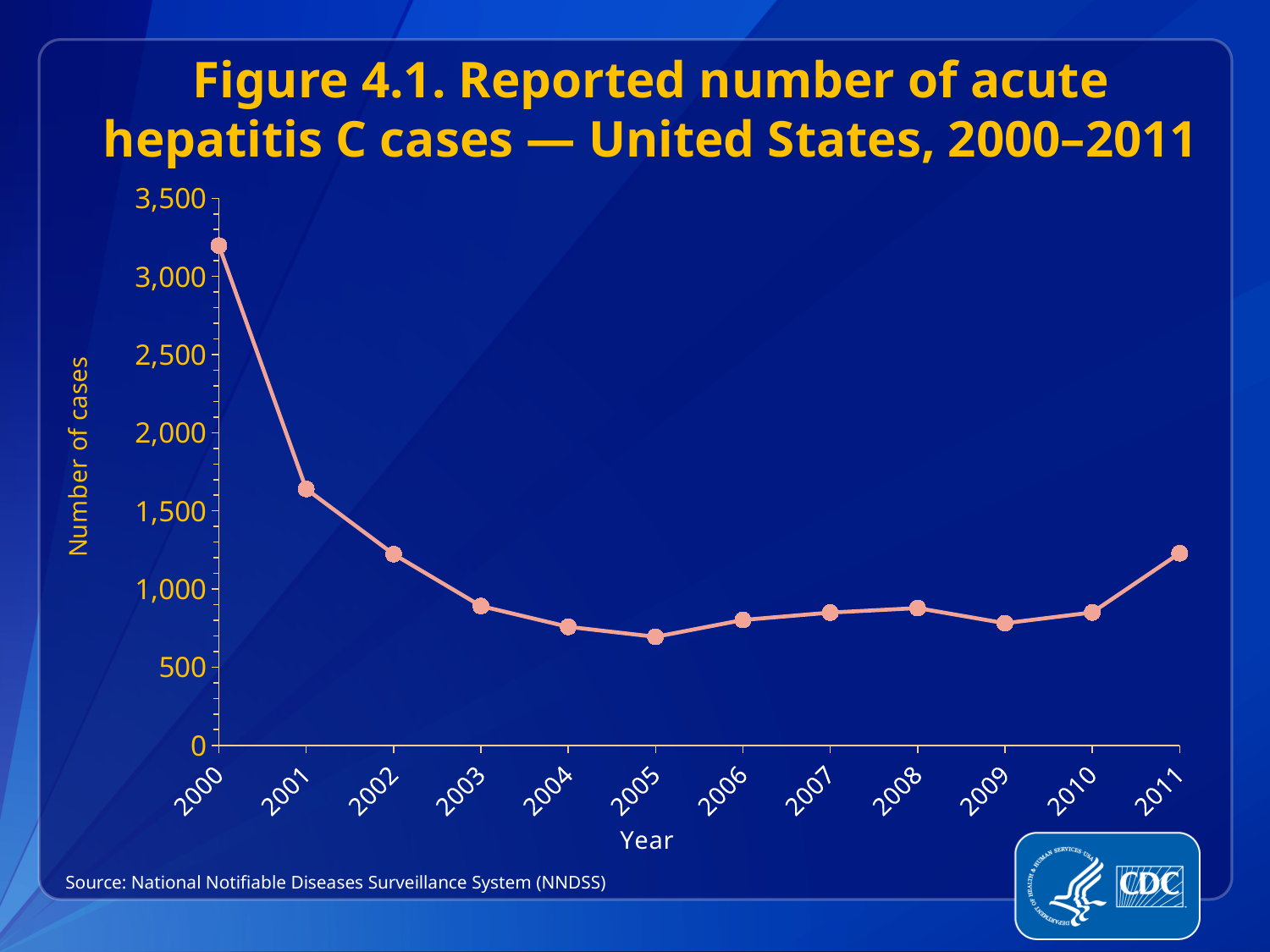
Which year has the highest reported number of acute hepatitis C cases? 2000 Is the number of cases in 2000 greater or less than 3,000? greater Which year had more reported cases, 2000 or 2011? 2000 Is the number of cases in 2001 greater or less than 1,500? greater Do the reported cases rise or fall from 2000 to 2005? fall How many years (data points) are plotted on the chart? 12 Is the number of cases in 2003 greater or less than 1,000? less Which year had more reported cases, 2001 or 2002? 2001 Which year has the lowest reported number of acute hepatitis C cases? 2005 What is the label on the vertical axis of the chart? Number of cases What kind of chart is shown on the slide? line chart